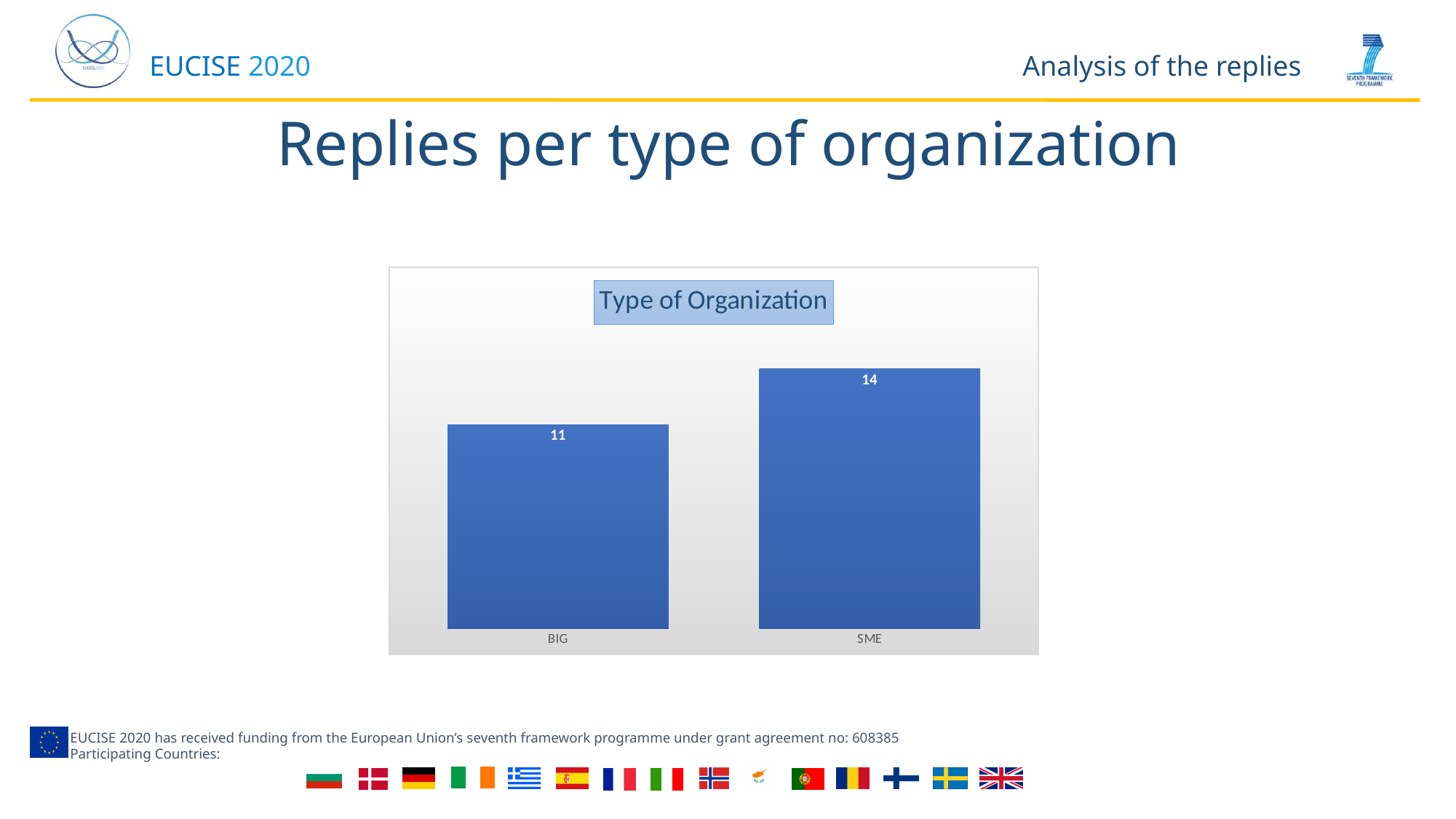
What colour are the bars in the chart? Blue Which type of organization has the lowest number of replies? BIG How many categories are shown in the chart? 2 What is the total of the values for BIG and SME? 25 What is the difference between the values for SME and BIG? 3 Which is larger, the value for BIG or the value for SME? SME What is the title of the chart? Type of Organization Which type of organization has the highest number of replies? SME What is the value for SME in the Type of Organization chart? 14 What is the value for BIG in the Type of Organization chart? 11 What kind of chart is shown on the slide? Bar chart